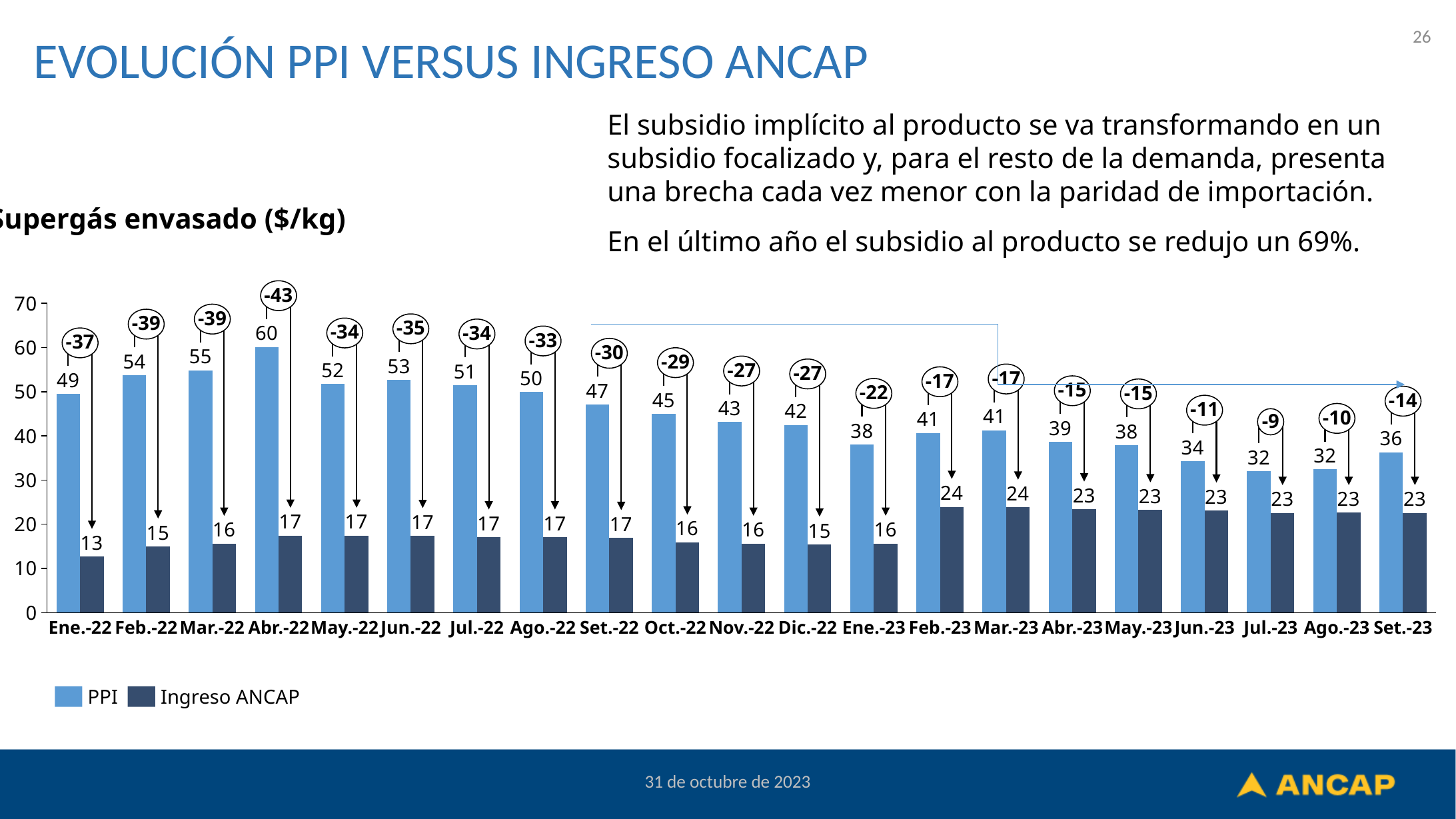
How many series does the legend list? 2 How many months are shown on the x axis? 21 What is the Ingreso ANCAP value for Ene.-22? 13 What is the PPI value for Abr.-22? 60 Which is larger, the PPI value for Ene.-22 or the PPI value for Feb.-22? Feb.-22 In which month is the PPI value highest? Abr.-22 Does the PPI series generally rise or fall from Ene.-22 to Set.-23? Fall What kind of chart is shown on the slide? Bar chart What is the Ingreso ANCAP value for Set.-23? 23 In which month is the Ingreso ANCAP value lowest? Ene.-22 What is the difference between the PPI value for Abr.-22 and the PPI value for Set.-23? 24 What is the title shown above the chart? Supergás envasado ($/kg)